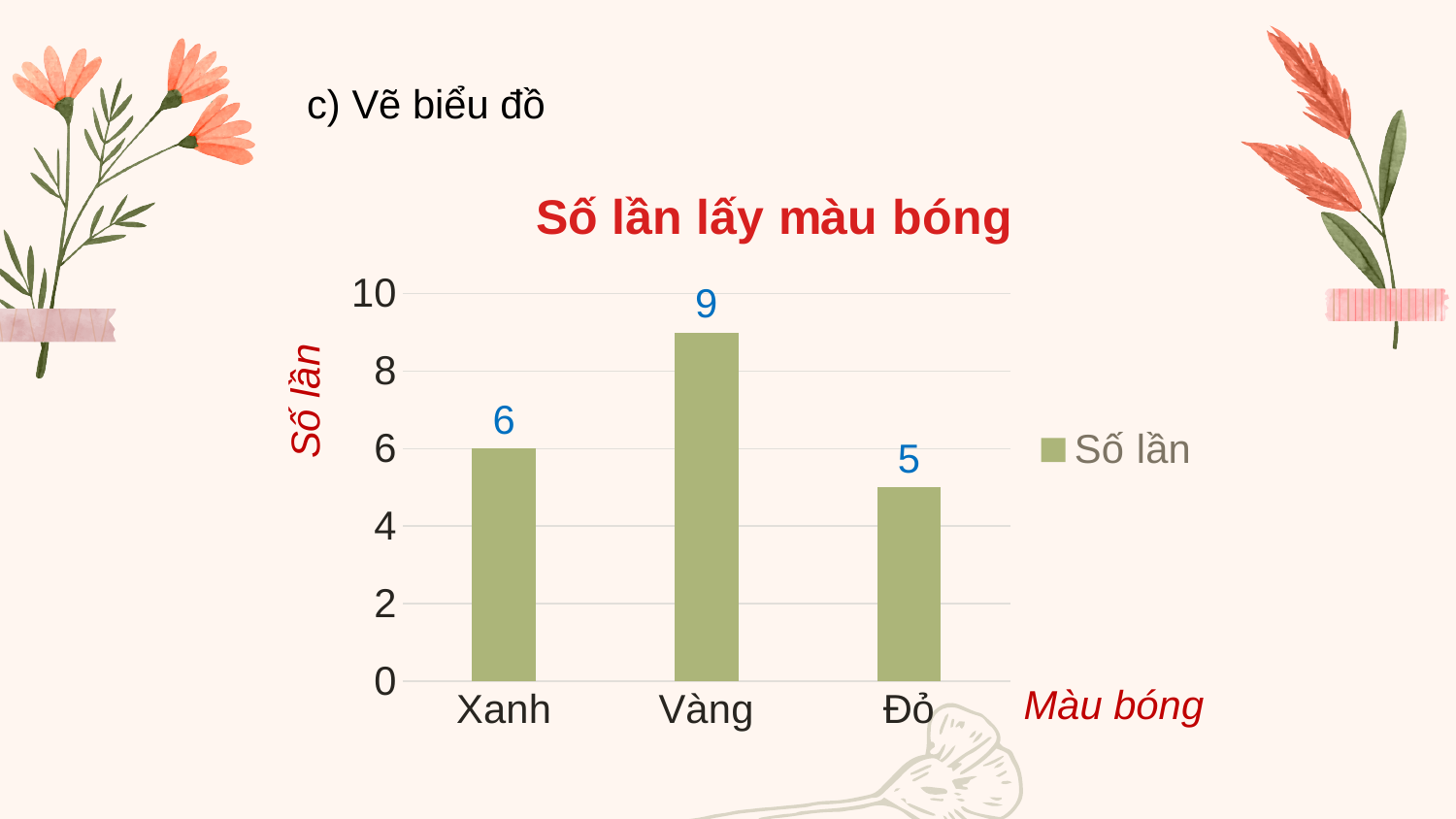
Which is larger, the value for Vàng or the value for Đỏ? Vàng What is the title of the chart? Số lần lấy màu bóng How many categories are shown on the x axis? 3 What is the value for Xanh? 6 Which category has the lowest value? Đỏ What is the value for Đỏ? 5 What is the difference between the values for Xanh and Đỏ? 1 What is the value for Vàng? 9 Which category has the highest value? Vàng Is the value for Vàng greater or less than 8? greater What is the difference between the values for Vàng and Xanh? 3 What kind of chart is shown? bar chart